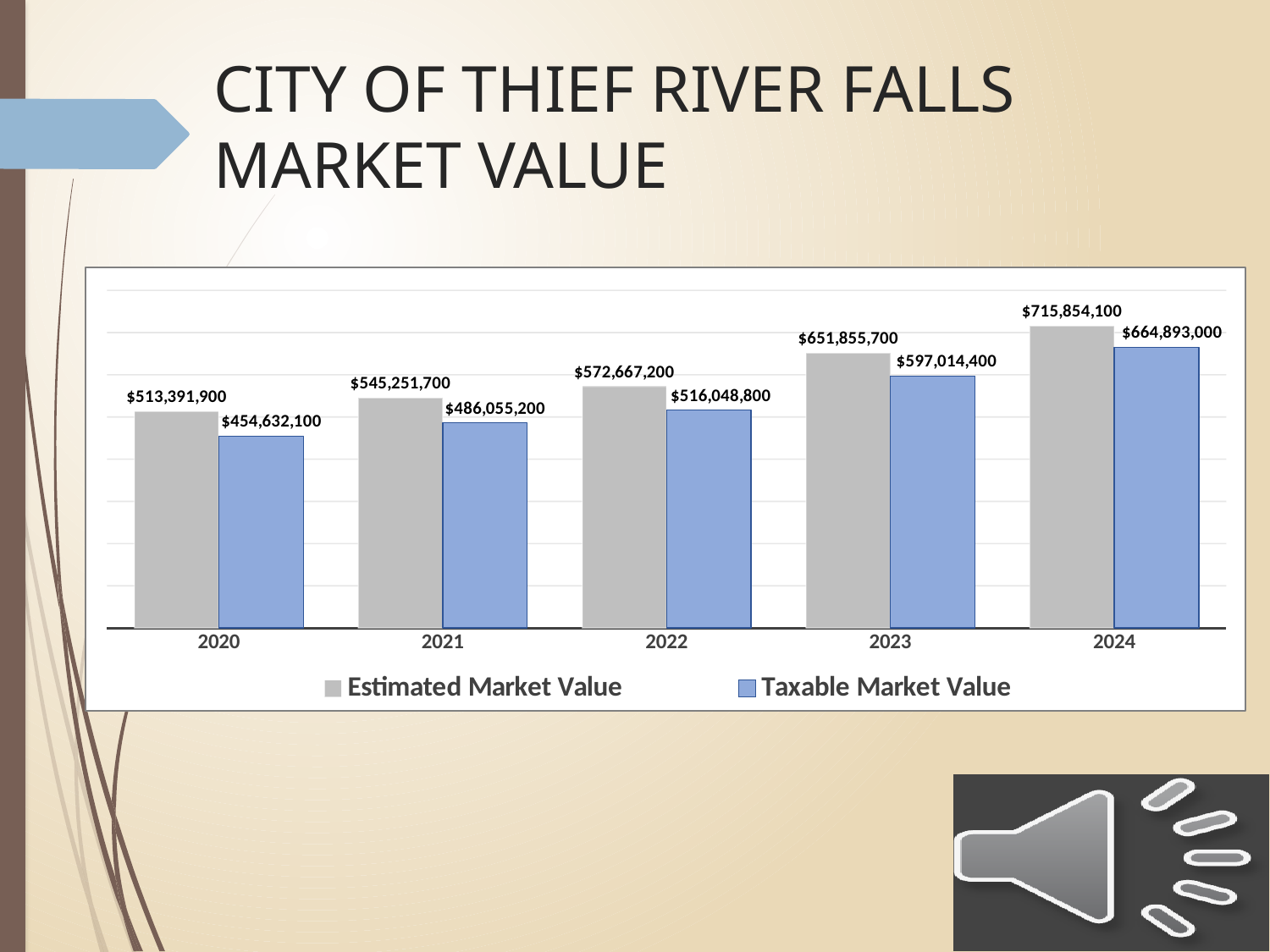
Which is larger in 2021, the Estimated Market Value or the Taxable Market Value? Estimated Market Value What is the Estimated Market Value for 2020? $513,391,900 What is the difference between the Estimated Market Value and the Taxable Market Value in 2024? $50,961,100 Does the Taxable Market Value rise or fall from 2020 to 2024? Rise How many series does the legend list? 2 Which year has the highest Estimated Market Value? 2024 What is the Taxable Market Value for 2022? $516,048,800 Which year has the lowest Taxable Market Value? 2020 What is the Taxable Market Value for 2024? $664,893,000 What kind of chart is shown on the slide? Bar chart How many years are shown on the x axis? 5 What is the Estimated Market Value for 2023? $651,855,700